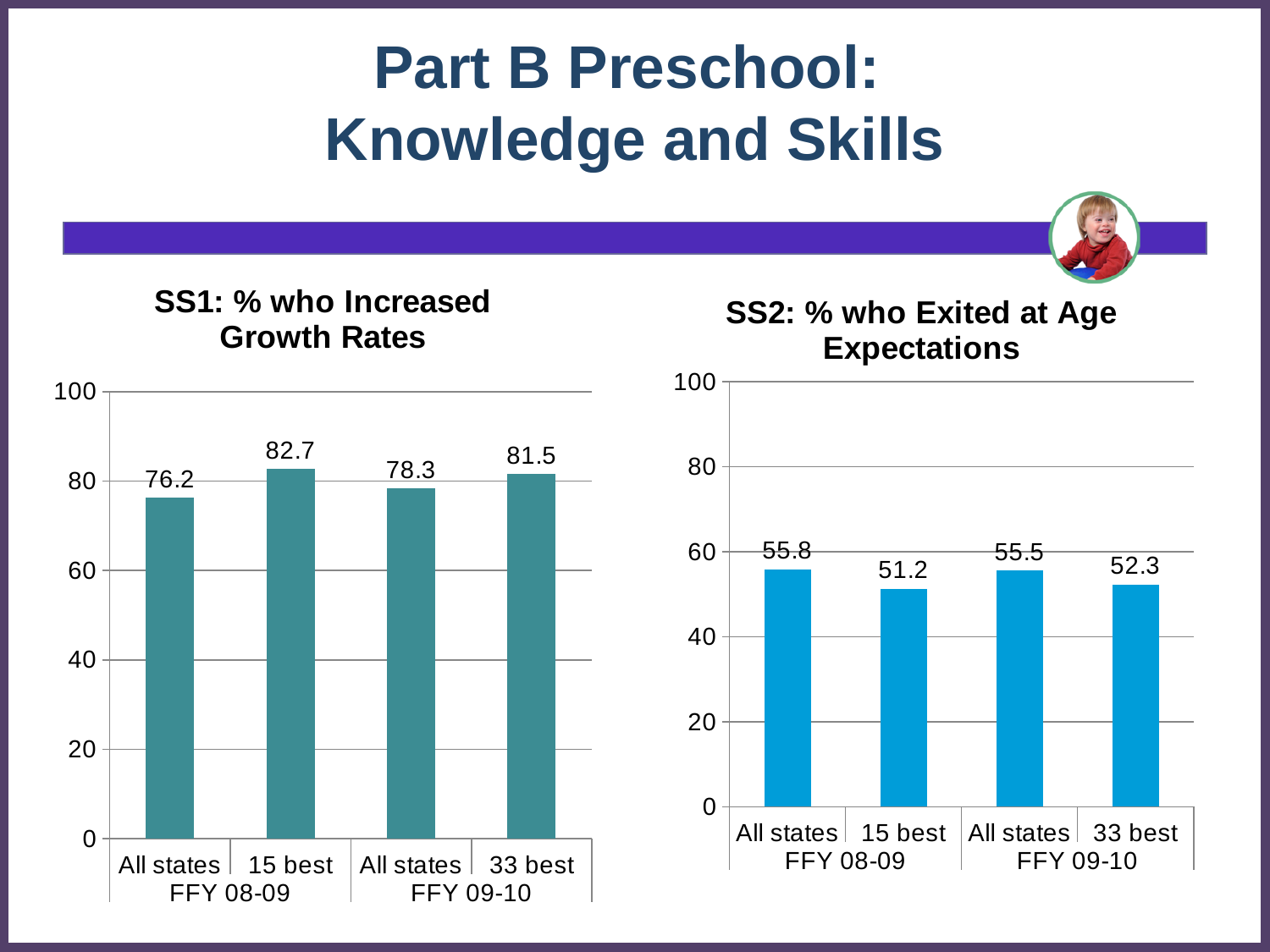
In the SS2: % who Exited at Age Expectations chart, what is the difference between All states and 33 best for FFY 09-10? 3.2 In the SS1: % who Increased Growth Rates chart, what is the value for 15 best in FFY 08-09? 82.7 In the SS1: % who Increased Growth Rates chart, what is the value for All states in FFY 08-09? 76.2 In the SS2: % who Exited at Age Expectations chart, which bar has the lowest value? 15 best, FFY 08-09 In the SS1: % who Increased Growth Rates chart, which bar has the highest value? 15 best, FFY 08-09 In the SS1: % who Increased Growth Rates chart, is the value for All states in FFY 09-10 greater or less than 80? less In the SS1: % who Increased Growth Rates chart, what is the difference between the 15 best and All states values for FFY 08-09? 6.5 What is the title of the chart on the right side of the slide? SS2: % who Exited at Age Expectations What kind of chart is the SS2: % who Exited at Age Expectations chart? bar chart In the SS2: % who Exited at Age Expectations chart, what is the value for 33 best in FFY 09-10? 52.3 In the SS2: % who Exited at Age Expectations chart, which is larger: All states in FFY 08-09 or 15 best in FFY 08-09? All states in FFY 08-09 How many bars are plotted in the SS1: % who Increased Growth Rates chart? 4